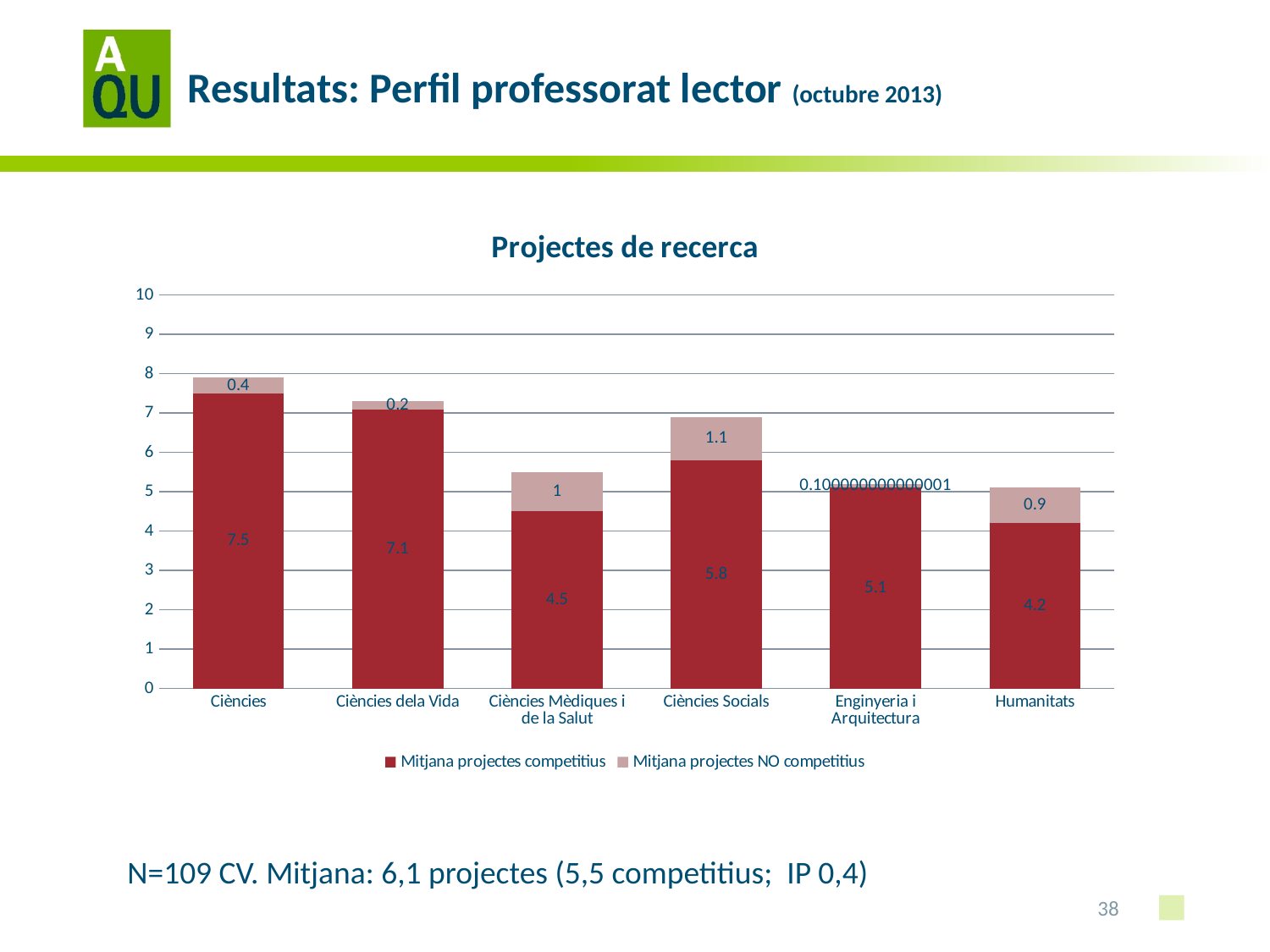
How many series does the legend list? 2 What is the title of the chart? Projectes de recerca What kind of chart is shown on the slide? stacked bar chart How many categories are shown on the x axis? 6 What is the value of Mitjana projectes competitius for Humanitats? 4.2 Which category has the highest value for Mitjana projectes competitius? Ciències What is the value of Mitjana projectes competitius for Ciències? 7.5 What is the total of the stacked bar for Ciències? 7.9 Which category has the lowest value for Mitjana projectes competitius? Humanitats What is the value of Mitjana projectes NO competitius for Ciències Socials? 1.1 Which is larger, the Mitjana projectes competitius value for Ciències Socials or for Ciències Mèdiques i de la Salut? Ciències Socials What is the difference between the Mitjana projectes competitius values for Ciències and Humanitats? 3.3